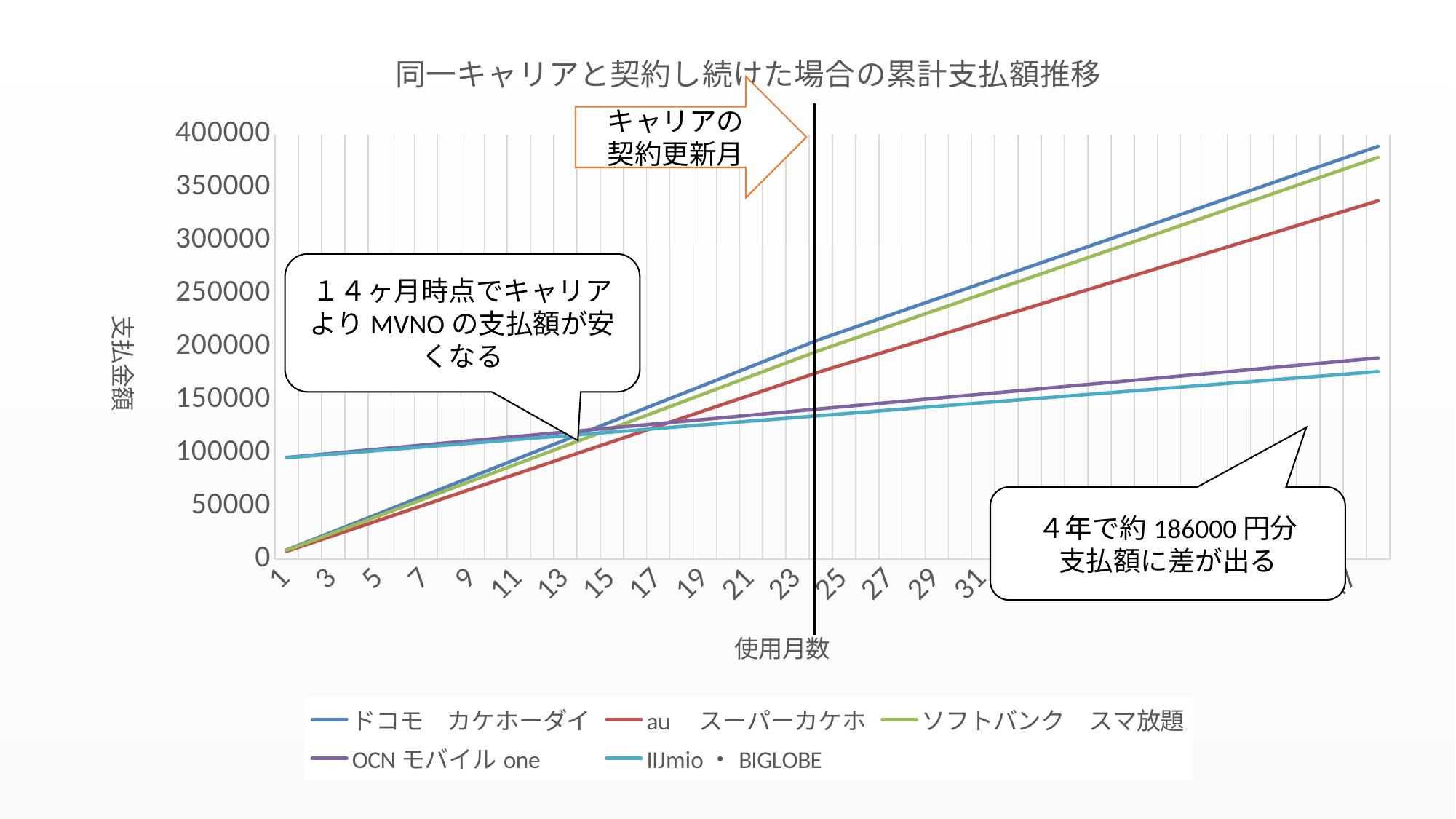
At the right end of the chart, is the value for OCN モバイル one greater or less than 200000? less At the right end of the chart, which is larger: the value for au スーパーカケホ or the value for ソフトバンク スマ放題? ソフトバンク スマ放題 At month 1, is the value for ドコモ カケホーダイ greater or less than 50000? less Which series has the highest cumulative payment at the right end of the chart? ドコモ カケホーダイ How many series does the legend list? 5 At month 1, is the value for IIJmio・BIGLOBE greater or less than 50000? greater Which series has the lowest cumulative payment at the right end of the chart? IIJmio・BIGLOBE What is the title of the chart? 同一キャリアと契約し続けた場合の累計支払額推移 What kind of chart is shown on the slide? line chart Do the values for ドコモ カケホーダイ rise or fall as the number of months increases? rise What is the label of the vertical axis? 支払金額